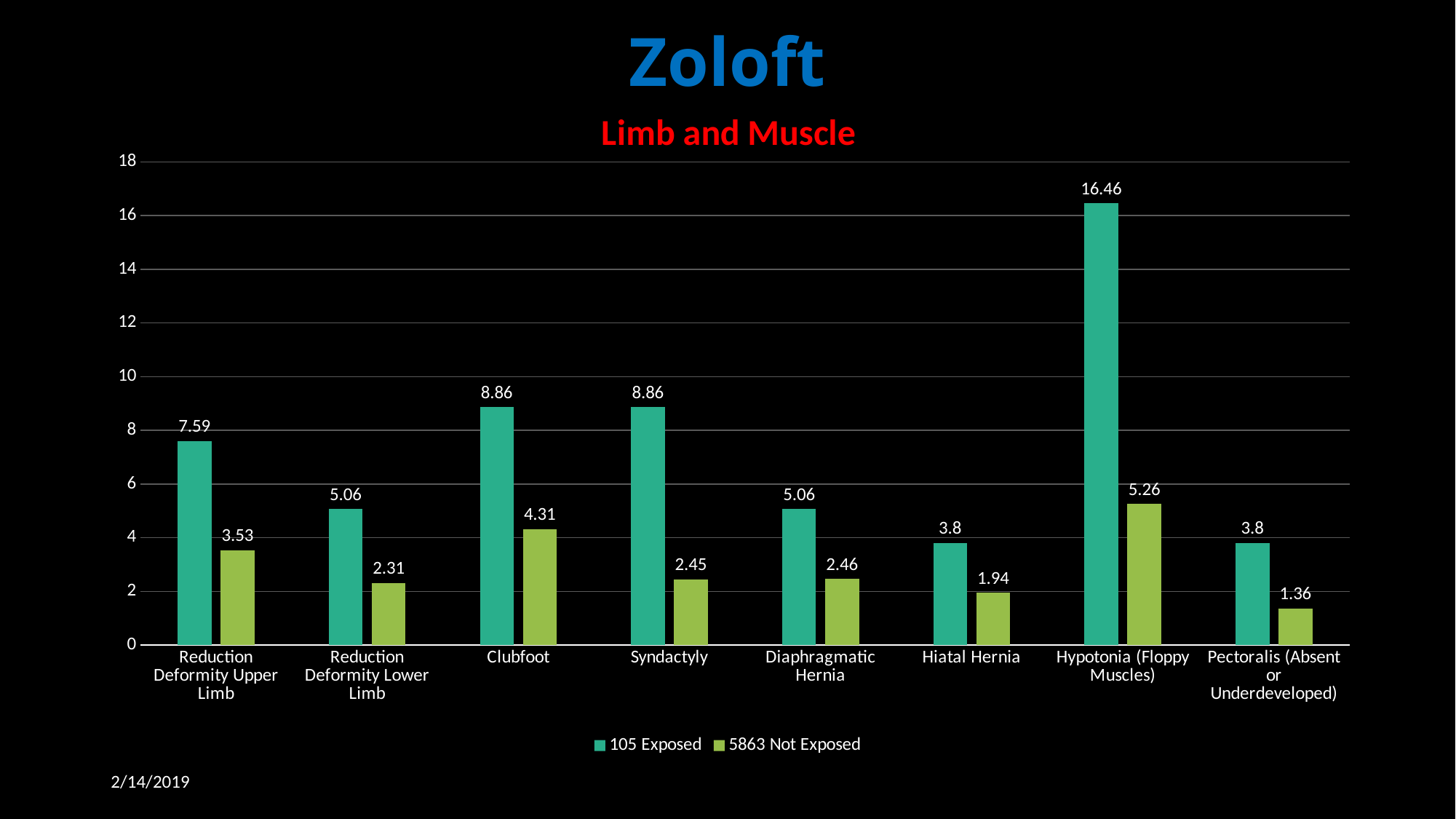
What kind of chart is shown on the slide? Bar chart What is the chart's title? Limb and Muscle What is the difference between the 105 Exposed and 5863 Not Exposed values for Reduction Deformity Upper Limb? 4.06 What is the value for 5863 Not Exposed for Hiatal Hernia? 1.94 Which category has the lowest value for 5863 Not Exposed? Pectoralis (Absent or Underdeveloped) What is the difference between the 105 Exposed and 5863 Not Exposed values for Hypotonia (Floppy Muscles)? 11.2 What is the value for 5863 Not Exposed for Hypotonia (Floppy Muscles)? 5.26 Which category has the highest value for 105 Exposed? Hypotonia (Floppy Muscles) How many series does the legend list? 2 Which is larger: the 5863 Not Exposed value for Clubfoot or the 5863 Not Exposed value for Syndactyly? Clubfoot What is the value for 105 Exposed for Clubfoot? 8.86 How many categories are shown on the x axis? 8